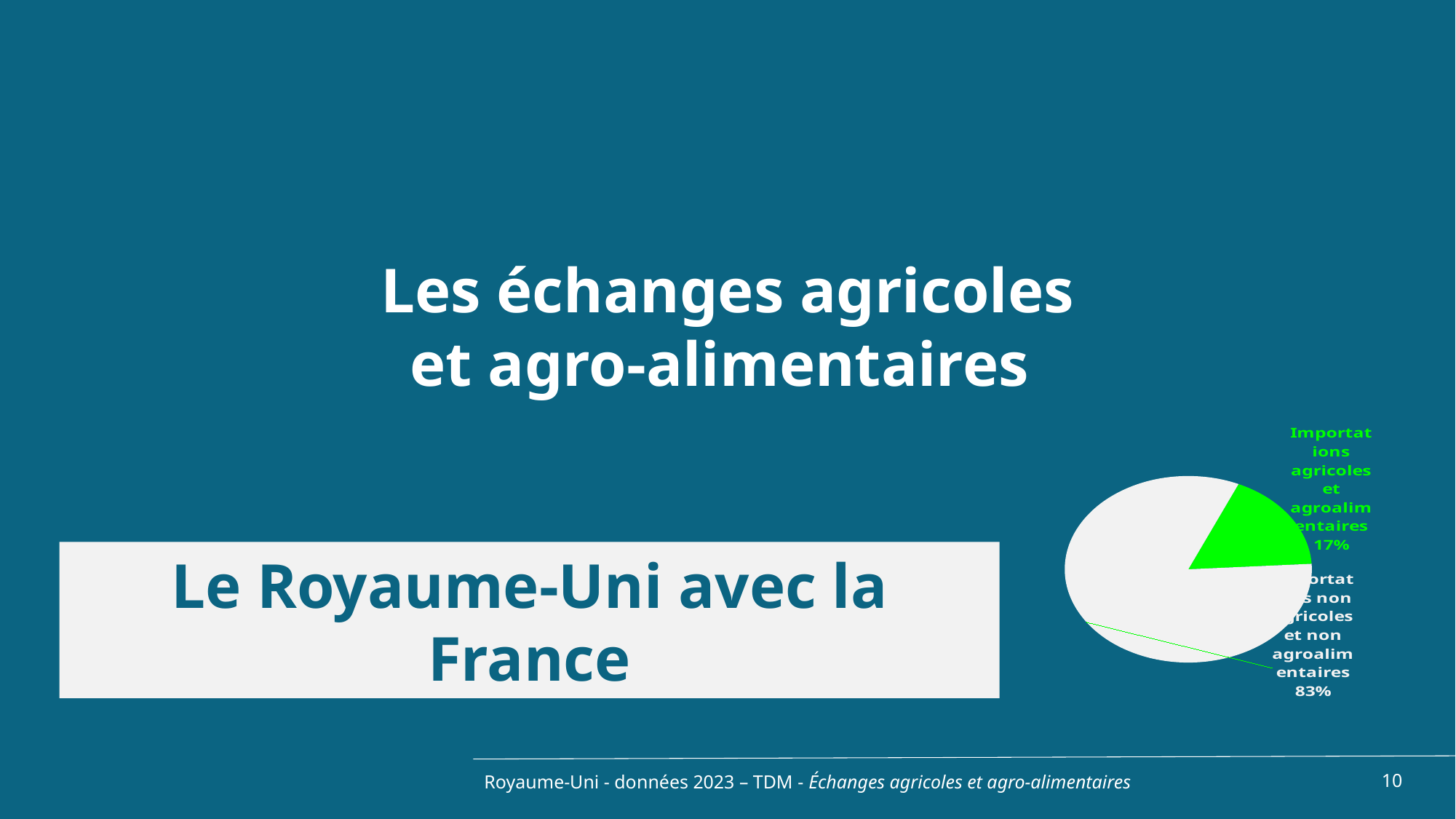
What colour is the slice for 'Importations agricoles et agroalimentaires' in the pie chart? green How many slices does the pie chart have? 2 Is the share for 'Importations agricoles et agroalimentaires' in the pie chart greater or less than 50%? less Which slice of the pie chart is the largest? Importations non agricoles et non agroalimentaires Which slice of the pie chart is the smallest? Importations agricoles et agroalimentaires In the pie chart, what share is labelled for 'Importations agricoles et agroalimentaires'? 17% What is the difference in percentage points between the two slices of the pie chart? 66 In the pie chart, what share is labelled for 'Importations non agricoles et non agroalimentaires'? 83% What kind of chart is shown on the right of the slide? pie chart Which is larger in the pie chart: the share of agricultural and agri-food imports or the share of non-agricultural imports? Importations non agricoles et non agroalimentaires